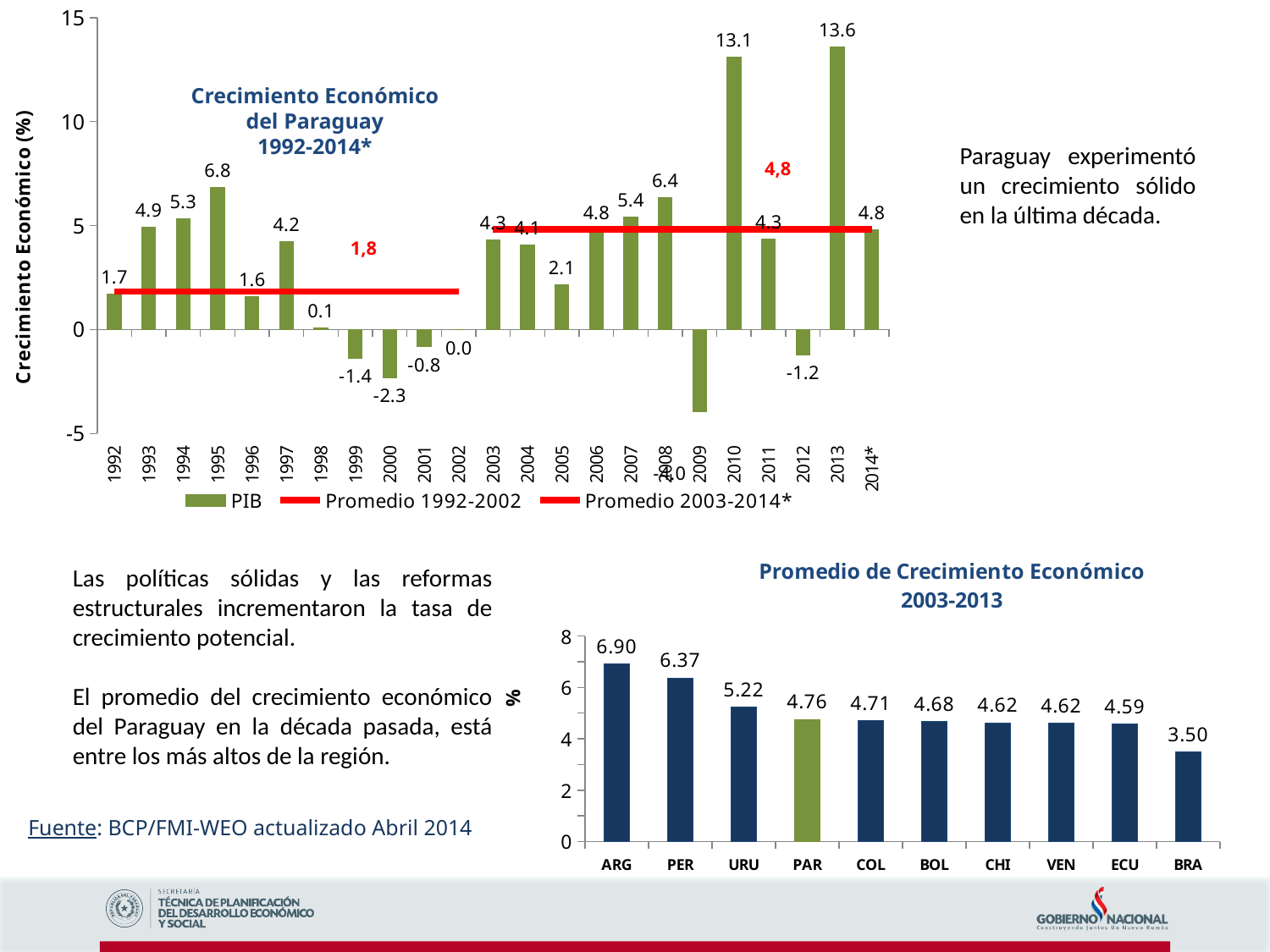
In the chart 'Promedio de Crecimiento Económico 2003-2013', how many countries are shown? 10 In the chart 'Crecimiento Económico del Paraguay 1992-2014*', what is the value for 2000? -2.3 In the chart 'Crecimiento Económico del Paraguay 1992-2014*', is the value for 1995 larger or smaller than the value for 1997? larger In the chart 'Crecimiento Económico del Paraguay 1992-2014*', which year has the highest value? 2013 In the chart 'Promedio de Crecimiento Económico 2003-2013', what is the difference between the values for ARG and PER? 0.53 In the chart 'Promedio de Crecimiento Económico 2003-2013', which country has the lowest value? BRA In the chart 'Crecimiento Económico del Paraguay 1992-2014*', what is the difference between the values for 2013 and 2010? 0.5 In the chart 'Promedio de Crecimiento Económico 2003-2013', what is the value for PAR? 4.76 In the chart 'Crecimiento Económico del Paraguay 1992-2014*', how many entries does the legend list? 3 In the chart 'Crecimiento Económico del Paraguay 1992-2014*', what is the value of the Promedio 2003-2014* line? 4,8 In the chart 'Crecimiento Económico del Paraguay 1992-2014*', what is the value for 2010? 13.1 What kind of chart is 'Promedio de Crecimiento Económico 2003-2013'? bar chart